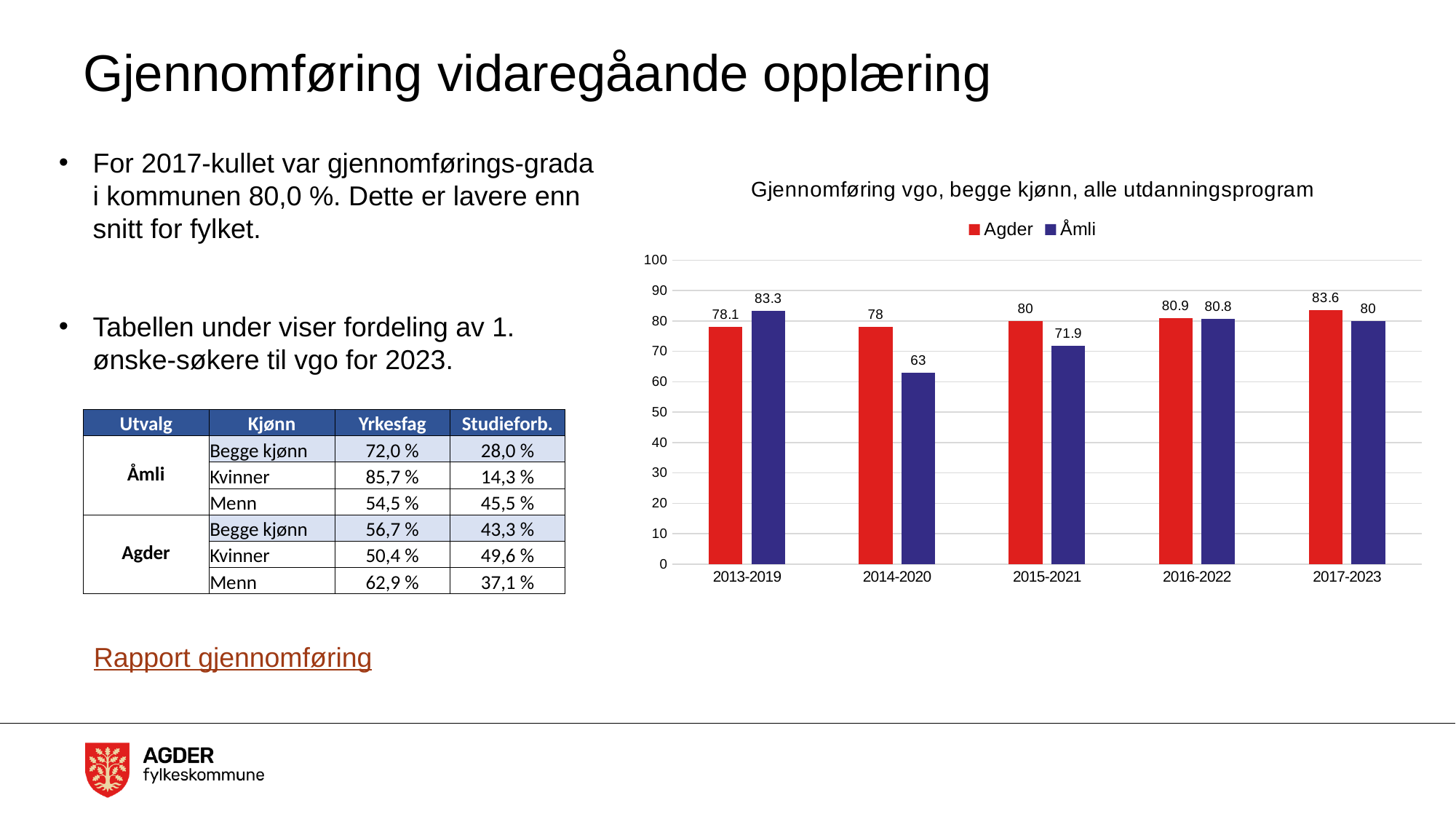
How many series does the legend list? 2 Which period has the highest value for Agder? 2017-2023 What is the value for Åmli in 2014-2020? 63 What is the value for Åmli in 2015-2021? 71.9 What is the value for Agder in 2017-2023? 83.6 What kind of chart is shown? Bar chart What is the title of the chart? Gjennomføring vgo, begge kjønn, alle utdanningsprogram Which period has the lowest value for Åmli? 2014-2020 Which is larger in 2015-2021, Agder or Åmli? Agder How many periods are shown on the x axis? 5 What is the difference between Agder and Åmli in 2014-2020? 15 What is the difference between Åmli and Agder in 2013-2019? 5.2